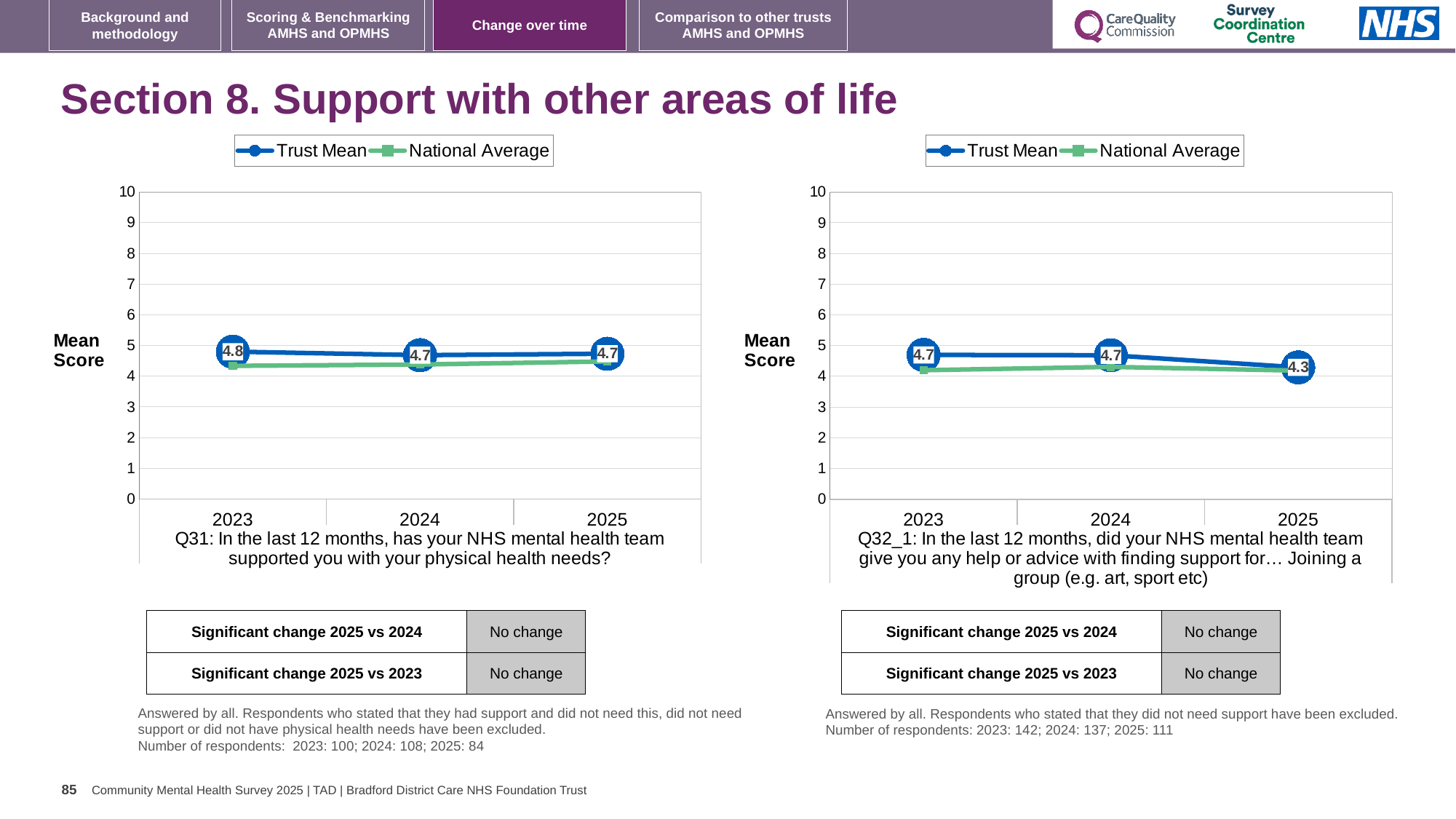
How many series does the legend of the right chart (Q32_1) list? 2 In the left chart (Q31), which is larger in 2023: the Trust Mean or the National Average? Trust Mean In the right chart (Q32_1), what is the Trust Mean for 2024? 4.7 In the right chart (Q32_1), what is the difference between the Trust Mean in 2024 and in 2025? 0.4 What kind of chart is the left chart (Q31)? Line chart In the right chart (Q32_1), which year has the lowest Trust Mean? 2025 In the right chart (Q32_1), is the National Average for 2023 greater or less than 5? less In the right chart (Q32_1), what is the Trust Mean for 2025? 4.3 In the left chart (Q31), what is the Trust Mean for 2025? 4.7 In the left chart (Q31), what is the Trust Mean for 2023? 4.8 How many years are plotted on the x axis of the left chart (Q31)? 3 In the left chart (Q31), which year has the highest Trust Mean? 2023